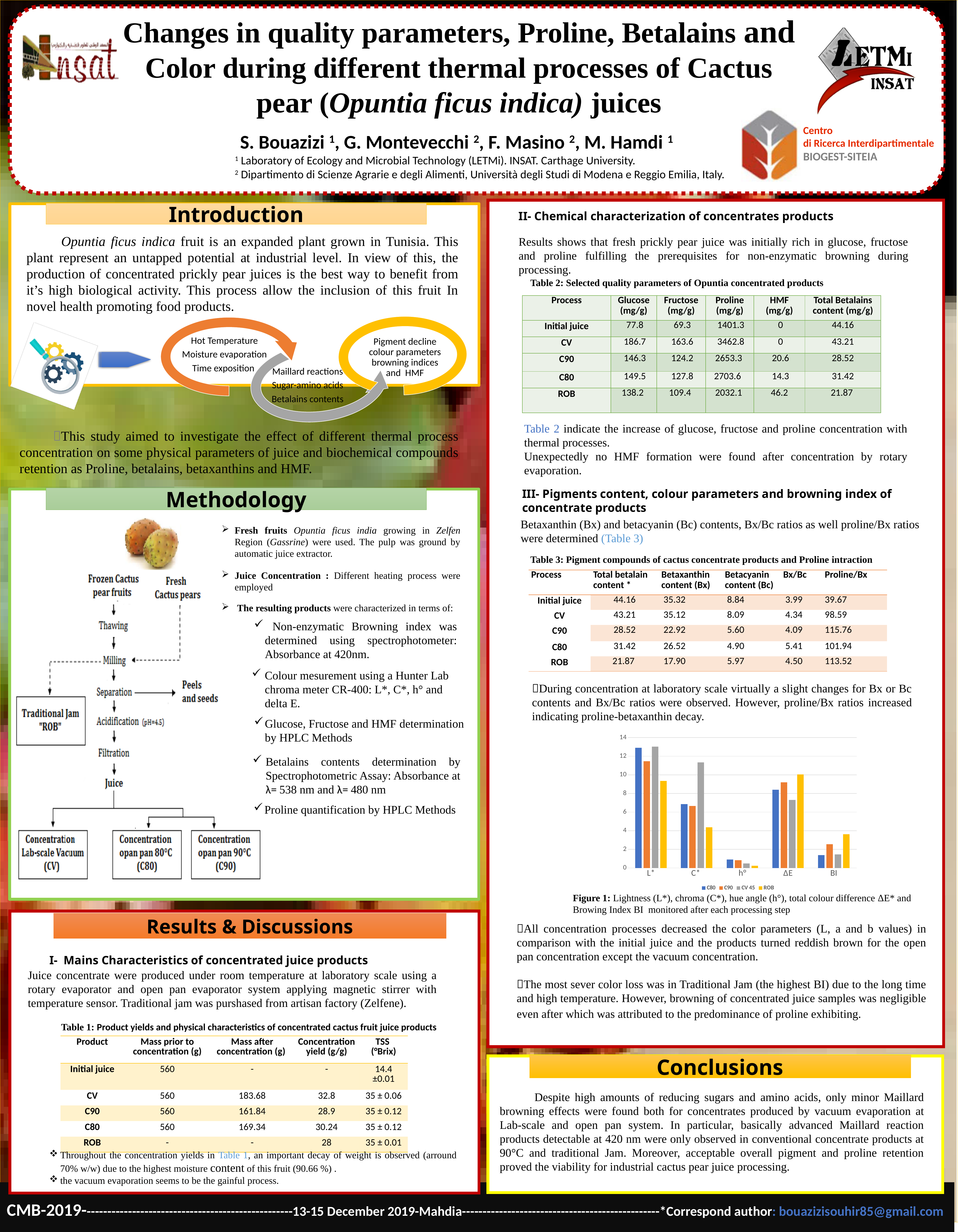
In the bar chart in Figure 1, which series has the highest value for BI? ROB In the bar chart in Figure 1, which series has the lowest value for L*? ROB In the bar chart in Figure 1, which is larger for ΔE: ROB or CV 45? ROB In the bar chart in Figure 1, is the value of ROB for ΔE greater or less than 8? greater In the bar chart in Figure 1, which series is shown in orange according to the legend? C90 How many series does the legend of the bar chart in Figure 1 list? 4 In the bar chart in Figure 1, is the value of CV 45 for C* greater or less than 10? greater In the bar chart in Figure 1, which series has the highest value for C*? CV 45 How many categories are shown on the x axis of the bar chart in Figure 1? 5 In the bar chart in Figure 1, is the value of ROB for L* greater or less than 10? less What kind of chart is Figure 1 on the slide? bar chart